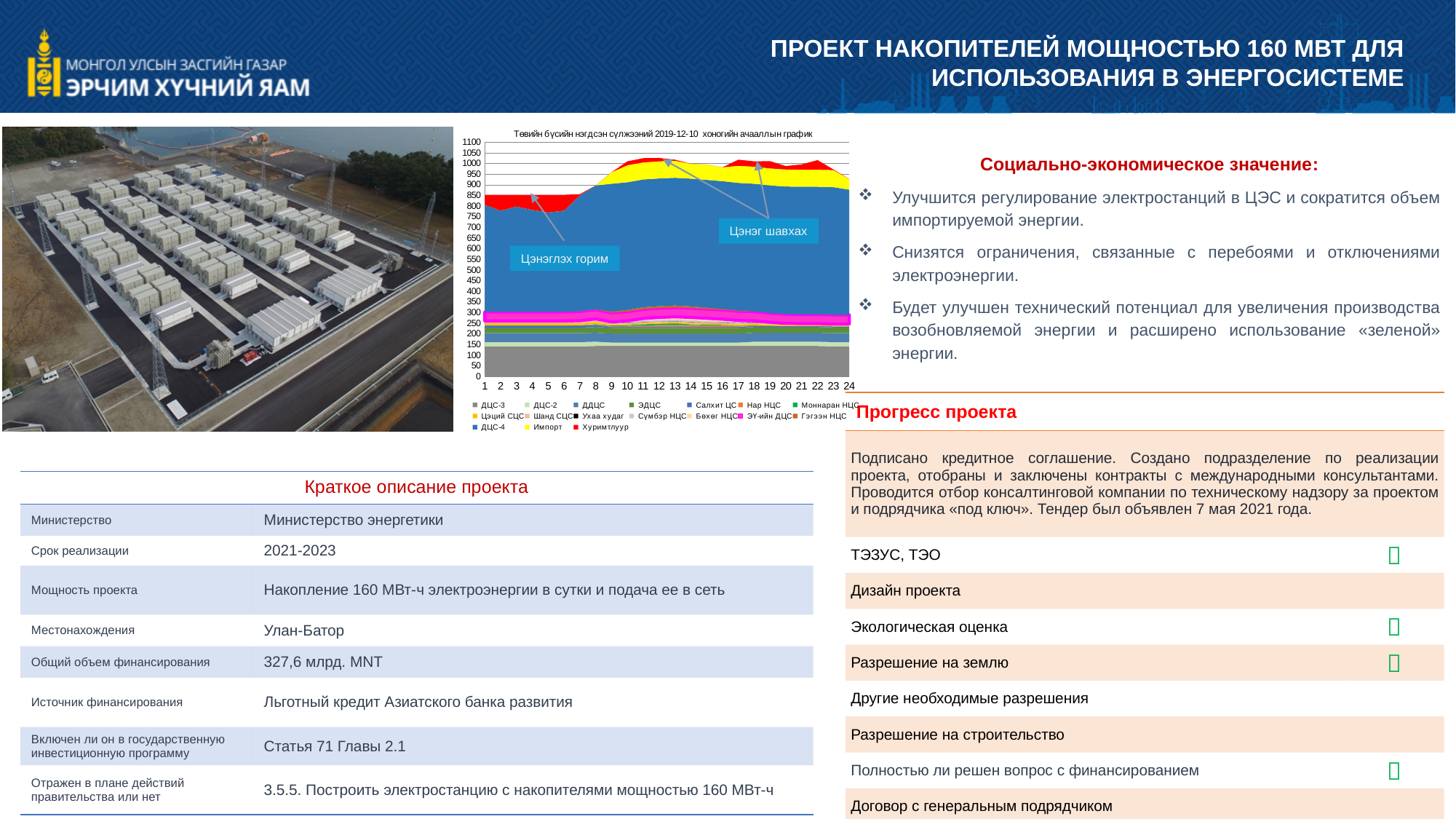
How many points (hours) are shown along the x axis of the chart? 24 Is the total stacked value at hour 3 greater or less than 900? less How many series does the chart's legend list? 17 What is the title of the chart on the slide? Төвийн бүсийн нэгдсэн сүлжээний 2019-12-10 хоногийн ачааллын график What is the highest value shown on the chart's y axis? 1100 Does the total stacked value rise or fall from hour 5 to hour 12? rise Which is larger, the total stacked value at hour 12 or at hour 3? hour 12 Which series in the legend is shown in yellow? Импорт What kind of chart is shown on the slide? Stacked area chart Is the total stacked value at hour 20 greater or less than 900? greater Is the total stacked value at hour 12 greater or less than 950? greater